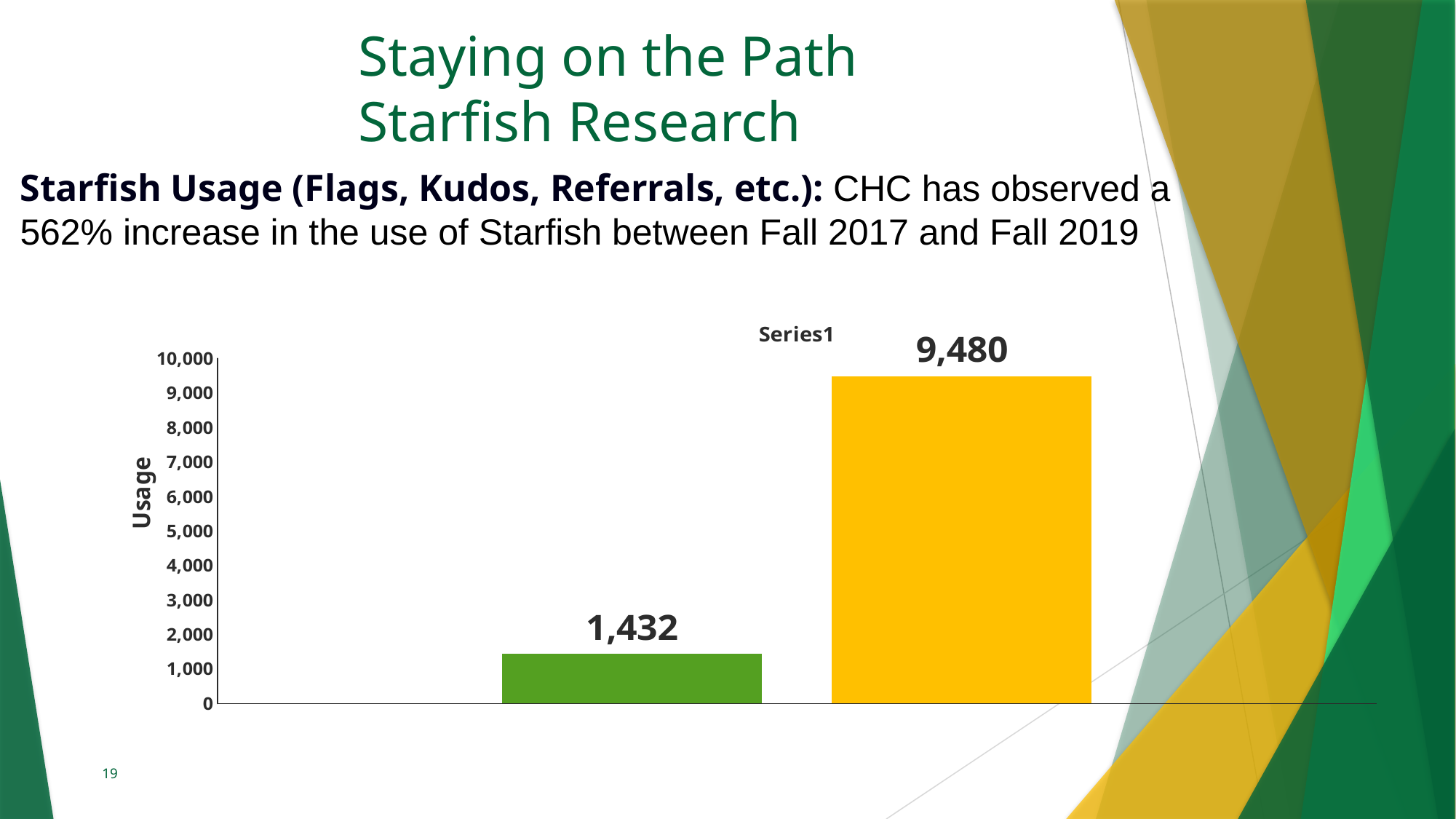
What is the title of the vertical axis of the chart? Usage Is the value of the green bar greater or less than 2,000? less What kind of chart is shown on the slide? bar chart Which bar has the highest value, the left (green) bar or the right (yellow) bar? the right (yellow) bar What is the value shown on the yellow bar (the right bar)? 9,480 How many bars are plotted in the chart? 2 Is the value of the green bar larger or smaller than the value of the yellow bar? smaller How many series does the legend list? 1 Is the value of the yellow bar greater or less than 9,000? greater What is the difference between the values of the yellow bar and the green bar? 8,048 Which bar has the lowest value, the left (green) bar or the right (yellow) bar? the left (green) bar What is the value shown on the green bar (the left bar)? 1,432